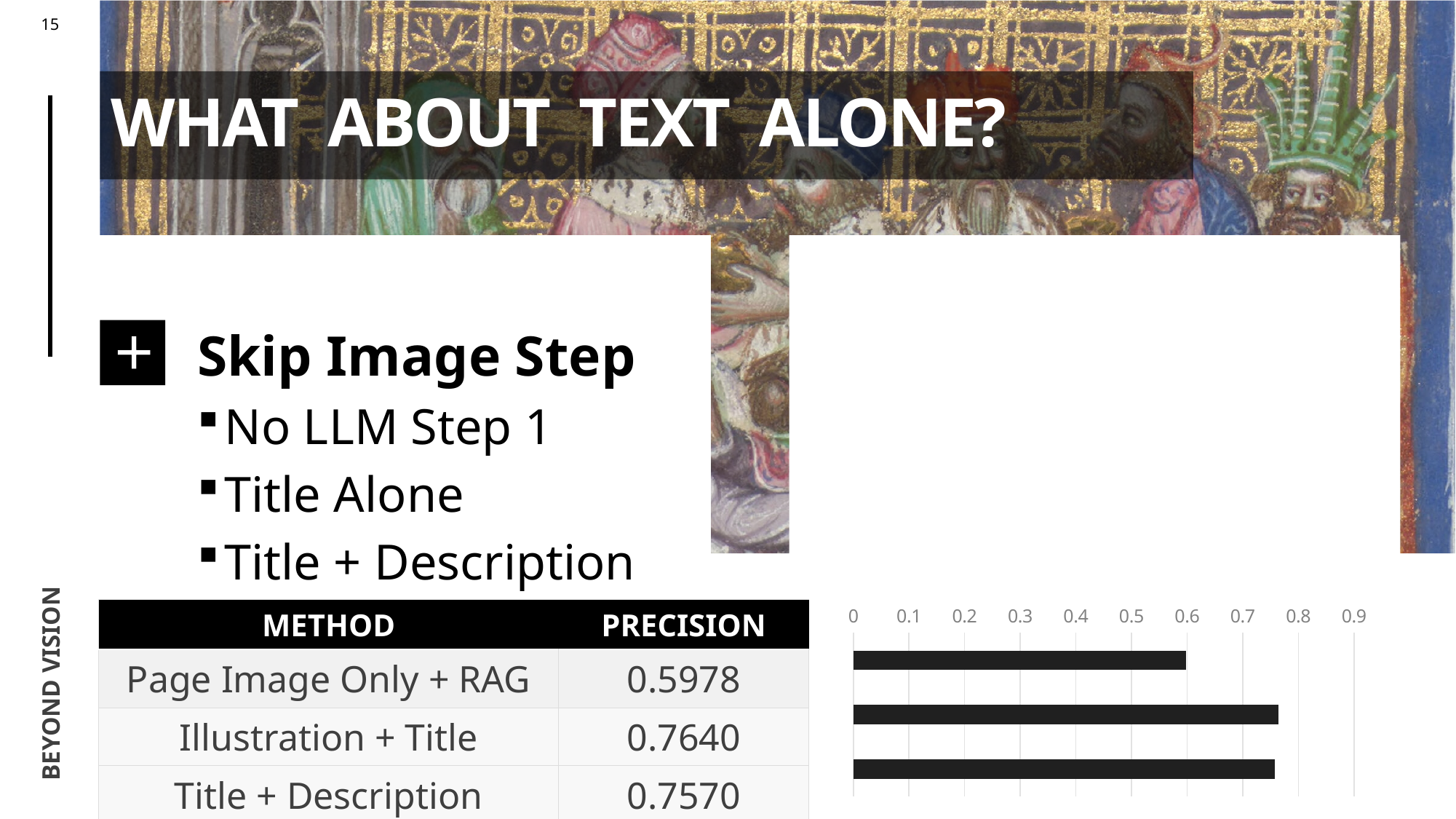
Is the value of the top bar in the chart greater or less than 0.5? greater Are the bars in the chart oriented horizontally or vertically? horizontally According to the table beside the chart, what is the precision for Illustration + Title? 0.7640 According to the table beside the chart, what is the precision for Page Image Only + RAG? 0.5978 How many bars does the chart contain? 3 Which is larger in the chart: the top bar or the middle bar? middle bar Is the value of the top bar in the chart greater or less than 0.7? less Is the value of the bottom bar in the chart greater or less than 0.8? less What is the highest tick value shown on the chart's axis? 0.9 What kind of chart is shown on the slide? bar chart Which bar in the chart is the shortest: the top, middle, or bottom bar? top